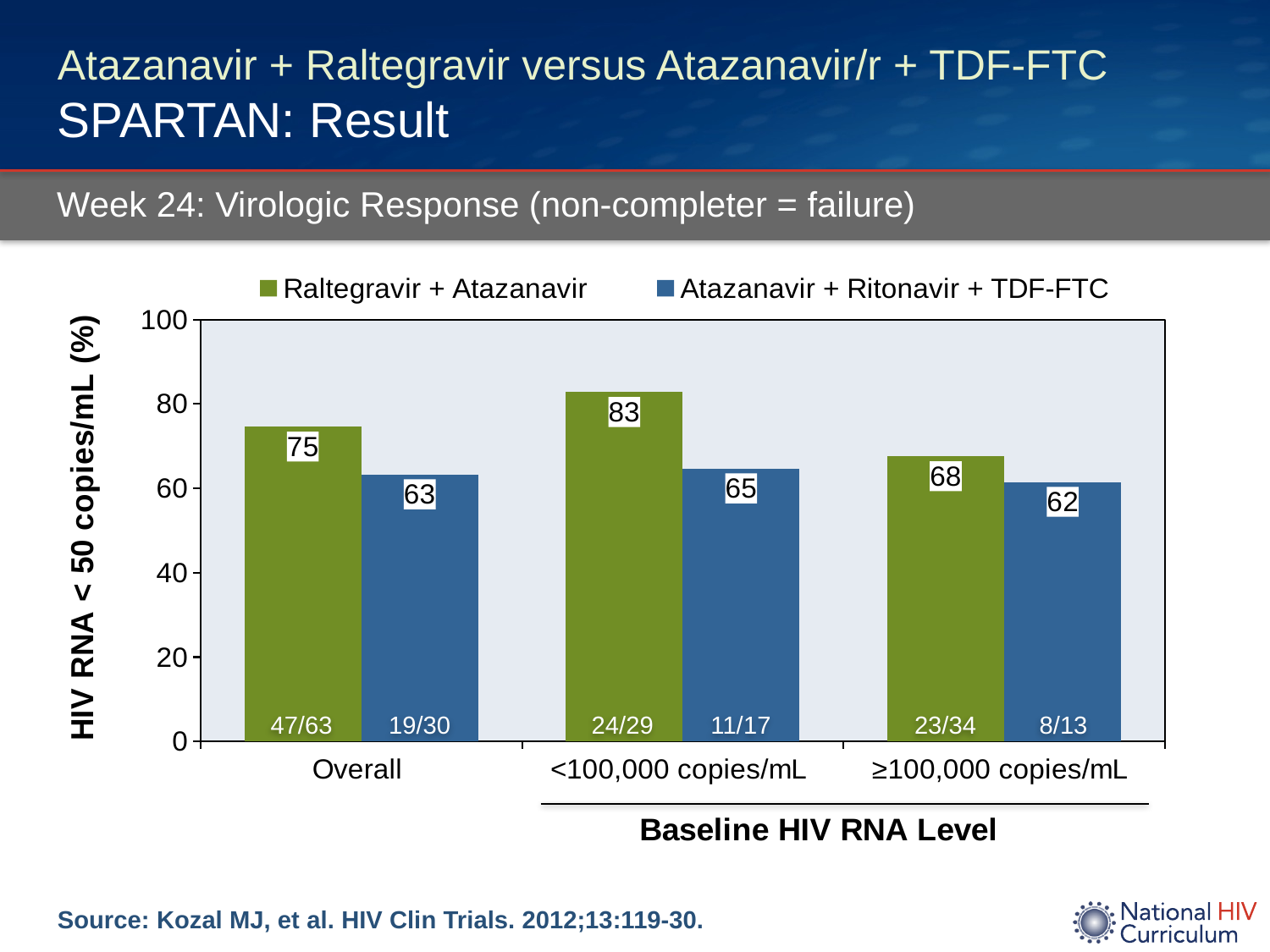
What is the label of the y axis? HIV RNA < 50 copies/mL (%) Which category has the highest value for Raltegravir + Atazanavir? <100,000 copies/mL What kind of chart is shown on the slide? bar chart How many series does the legend list? 2 Which category has the lowest value for Atazanavir + Ritonavir + TDF-FTC? ≥100,000 copies/mL What is the value for Raltegravir + Atazanavir in the ≥100,000 copies/mL category? 68 What is the value for Raltegravir + Atazanavir in the Overall category? 75 In the Overall category, which series has the larger value? Raltegravir + Atazanavir How many categories are shown on the x axis? 3 What is the difference between the Raltegravir + Atazanavir and Atazanavir + Ritonavir + TDF-FTC values in the <100,000 copies/mL category? 18 What is the value for Atazanavir + Ritonavir + TDF-FTC in the <100,000 copies/mL category? 65 Is the value for Atazanavir + Ritonavir + TDF-FTC in the Overall category greater or less than 80? less